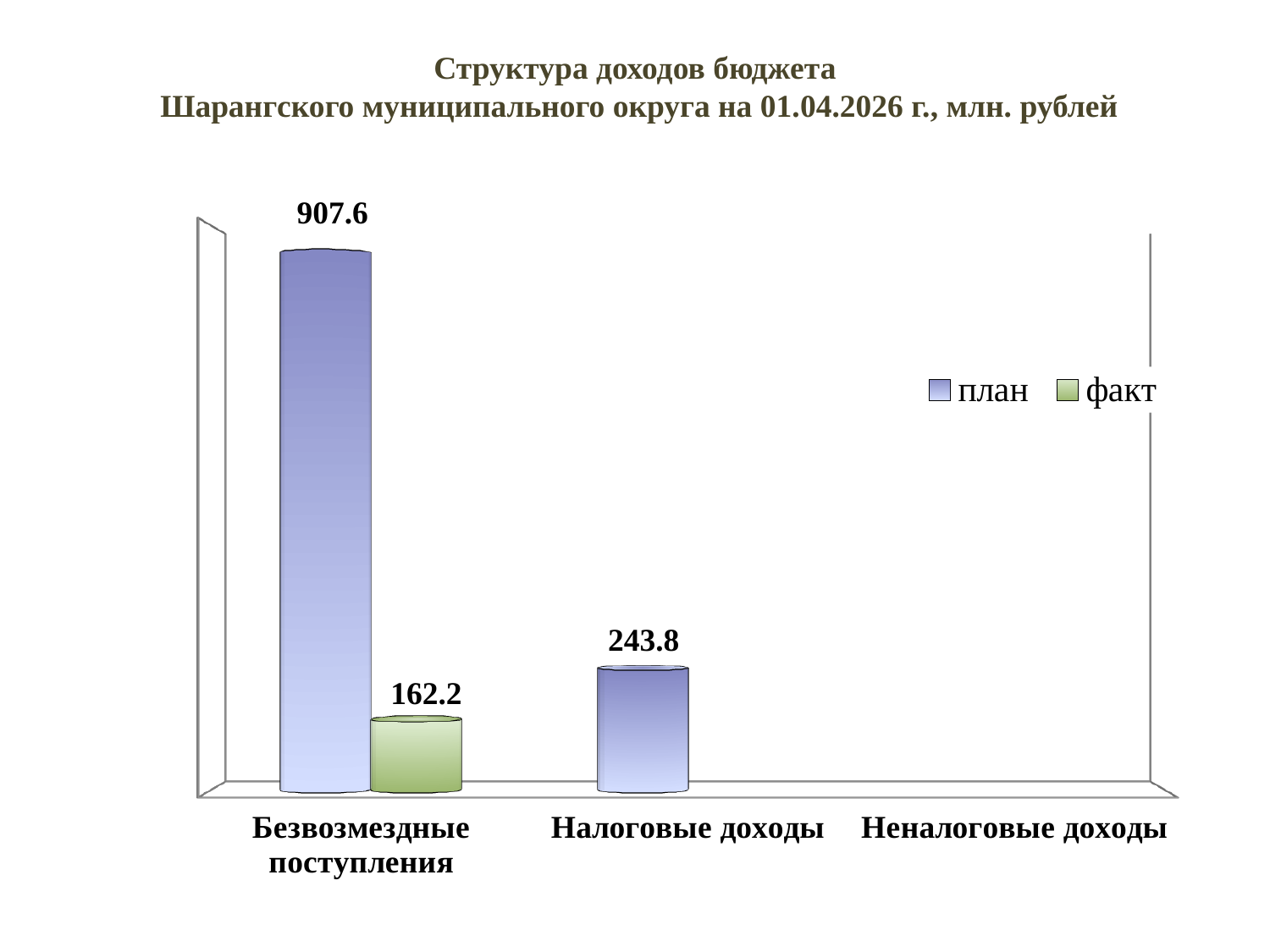
What is the difference between the план value for Безвозмездные поступления and the план value for Налоговые доходы? 663.8 Which is larger: the план value for Налоговые доходы or the факт value for Безвозмездные поступления? план value for Налоговые доходы How many series does the legend list? 2 What colour is the факт series in the chart? green What is the difference between the план and факт values for Безвозмездные поступления? 745.4 Which category has the highest план value? Безвозмездные поступления What is the план value for Налоговые доходы? 243.8 What is the факт value for Безвозмездные поступления? 162.2 What kind of chart is shown on the slide? bar chart What is the план value for Безвозмездные поступления? 907.6 What are the two series named in the legend? план and факт How many categories are shown on the x axis? 3